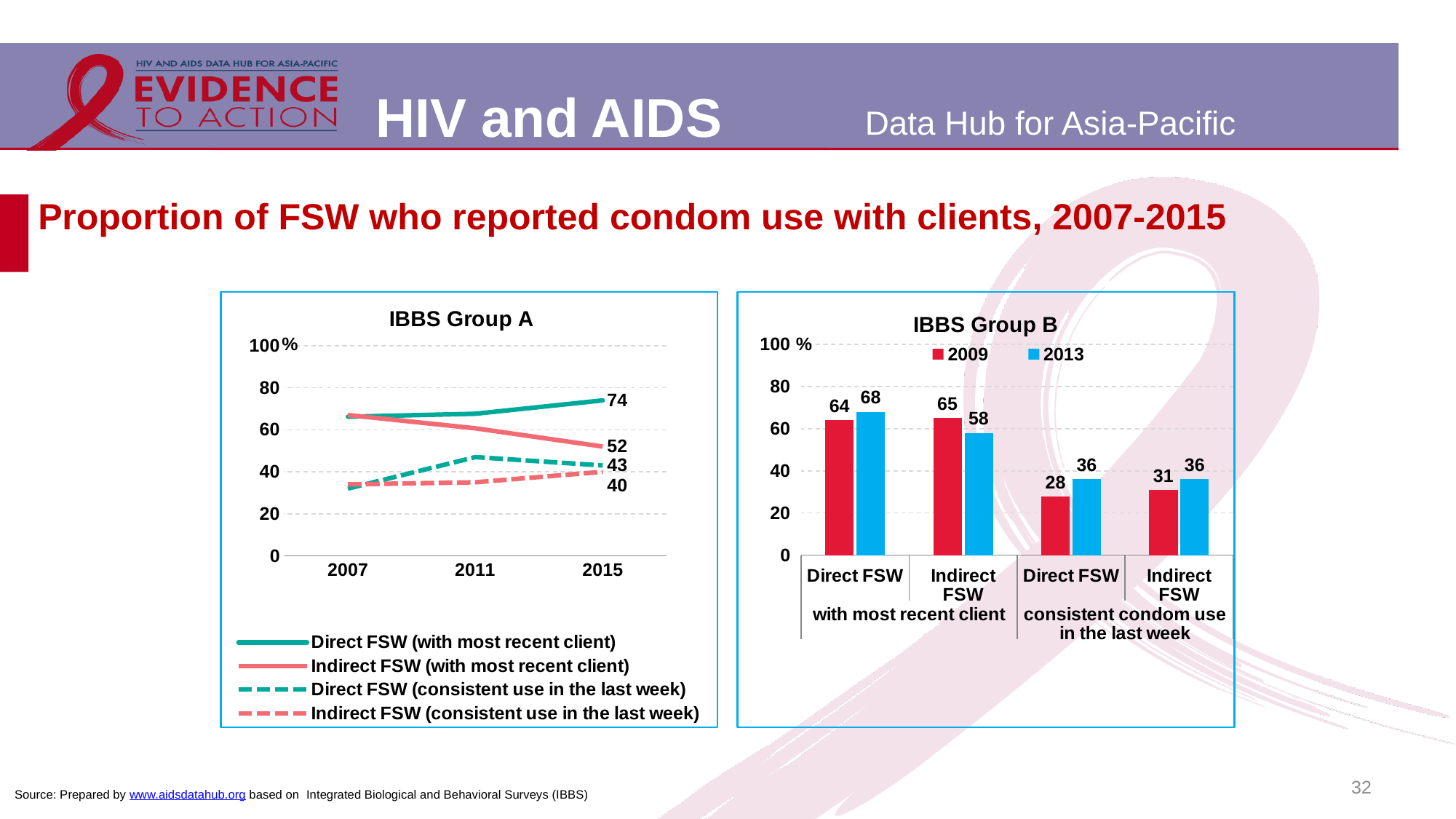
In the IBBS Group B chart, what is the 2009 value for Direct FSW consistent condom use in the last week? 28 In the IBBS Group B chart, which is larger for Indirect FSW with most recent client: the 2009 value or the 2013 value? 2009 In the IBBS Group B chart, what is the 2013 value for Indirect FSW with most recent client? 58 In the IBBS Group A chart, what is the 2015 value for Direct FSW (with most recent client)? 74 In the IBBS Group A chart, is the 2007 value for Direct FSW (consistent use in the last week) greater or less than 40? less In the IBBS Group A chart, what is the 2015 value for Indirect FSW (consistent use in the last week)? 40 In the IBBS Group A chart, does the Indirect FSW (with most recent client) line rise or fall from 2007 to 2015? fall What kind of chart is the IBBS Group B chart? bar chart In the IBBS Group A chart, how many series does the legend list? 4 In the IBBS Group B chart, what is the difference between the 2013 and 2009 values for Direct FSW consistent condom use in the last week? 8 In the IBBS Group B chart, which category has the lowest 2009 value? Direct FSW consistent condom use in the last week In the IBBS Group A chart, what is the difference between the 2015 values for Direct FSW (with most recent client) and Indirect FSW (with most recent client)? 22